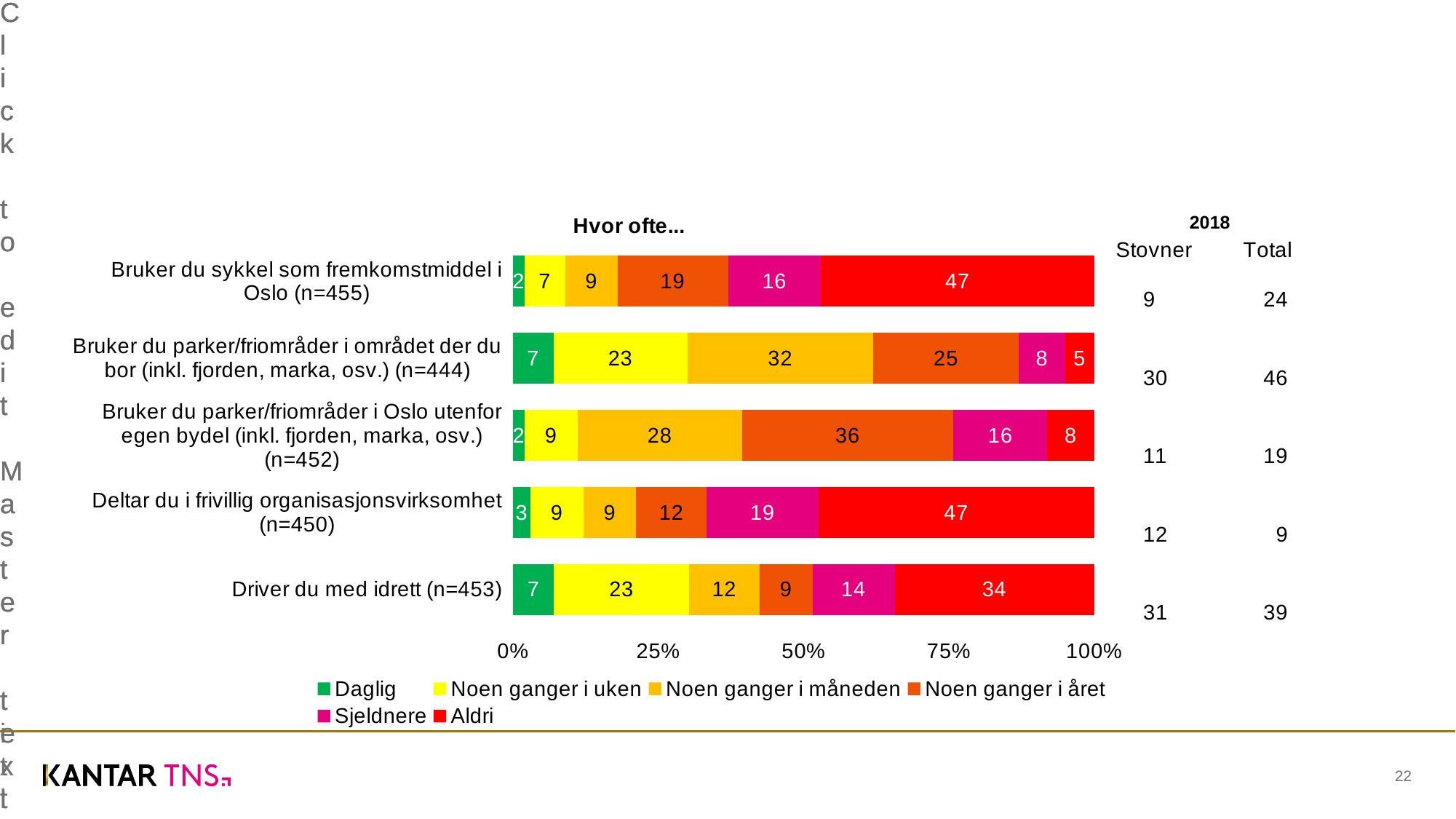
What is the title of the chart? Hvor ofte... Which category has the highest 'Noen ganger i året' value? Bruker du parker/friområder i Oslo utenfor egen bydel (inkl. fjorden, marka, osv.) (n=452) Which has the larger 'Daglig' value: 'Driver du med idrett (n=453)' or 'Deltar du i frivillig organisasjonsvirksomhet (n=450)'? Driver du med idrett (n=453) Which category has the lowest 'Aldri' value? Bruker du parker/friområder i området der du bor (inkl. fjorden, marka, osv.) (n=444) What kind of chart is shown on the slide? Stacked bar chart What is the total of all segments in the bar for 'Bruker du parker/friområder i området der du bor (inkl. fjorden, marka, osv.) (n=444)'? 100 How many series does the legend list? 6 How many categories (questions) are shown in the chart? 5 What is the value of the 'Aldri' segment for 'Bruker du sykkel som fremkomstmiddel i Oslo (n=455)'? 47 What is the value of the 'Noen ganger i måneden' segment for 'Bruker du parker/friområder i området der du bor (inkl. fjorden, marka, osv.) (n=444)'? 32 What is the value of the 'Sjeldnere' segment for 'Driver du med idrett (n=453)'? 14 What is the difference between the 'Aldri' value for 'Bruker du sykkel som fremkomstmiddel i Oslo (n=455)' and the 'Aldri' value for 'Driver du med idrett (n=453)'? 13